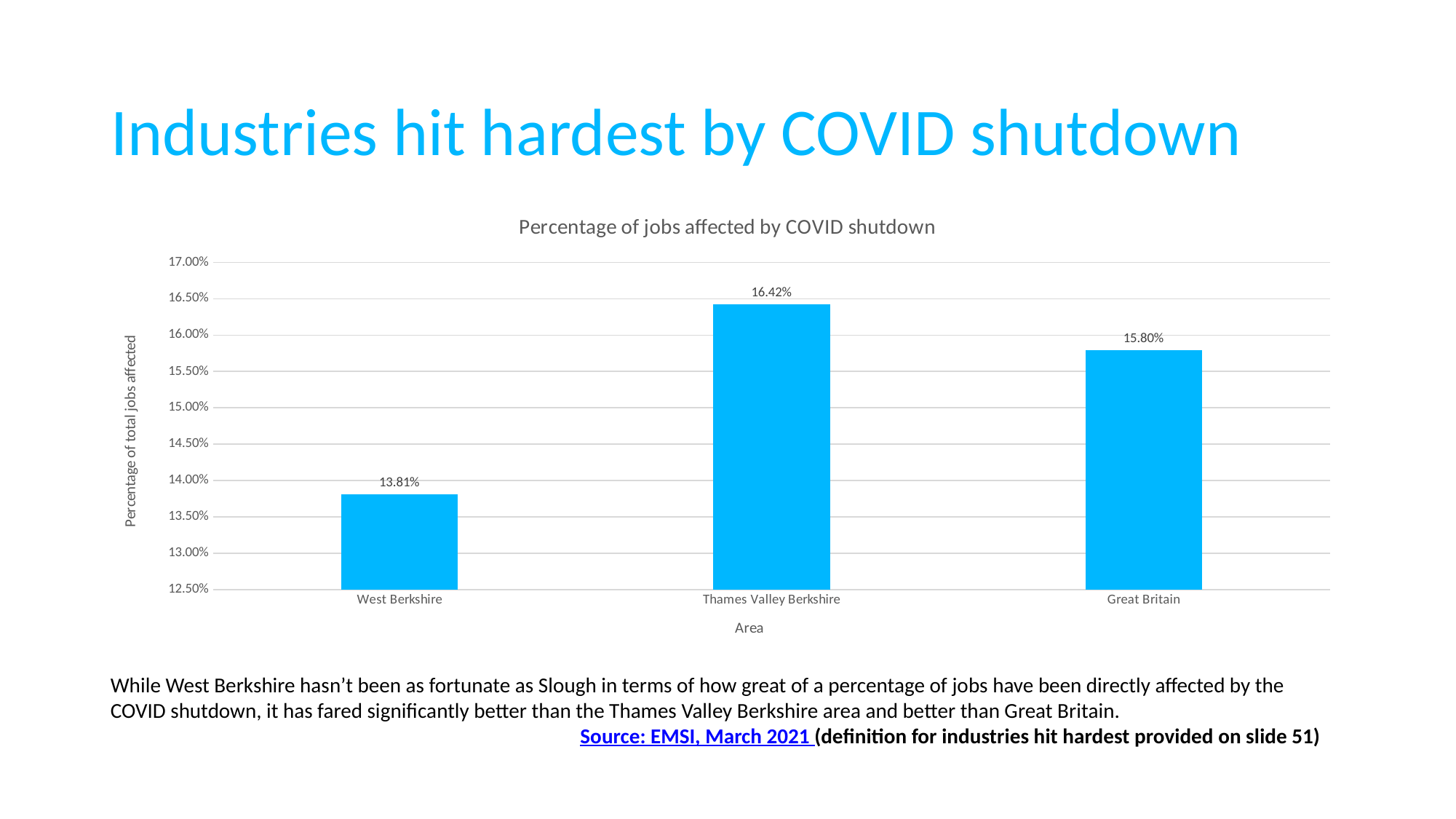
What is the percentage of jobs affected by COVID shutdown for Thames Valley Berkshire? 16.42% How many areas are shown in the chart? 3 What type of chart is shown on the slide? Bar chart What is the percentage of jobs affected by COVID shutdown for Great Britain? 15.80% Is the value for West Berkshire greater or less than 14.00%? less What is the percentage of jobs affected by COVID shutdown for West Berkshire? 13.81% Which has a higher percentage of jobs affected, Great Britain or West Berkshire? Great Britain Which area has the lowest percentage of jobs affected by COVID shutdown? West Berkshire What is the difference in percentage points between Thames Valley Berkshire and West Berkshire? 2.61% Which area has the highest percentage of jobs affected by COVID shutdown? Thames Valley Berkshire What is the difference in percentage points between Thames Valley Berkshire and Great Britain? 0.62% What is the title of the chart? Percentage of jobs affected by COVID shutdown